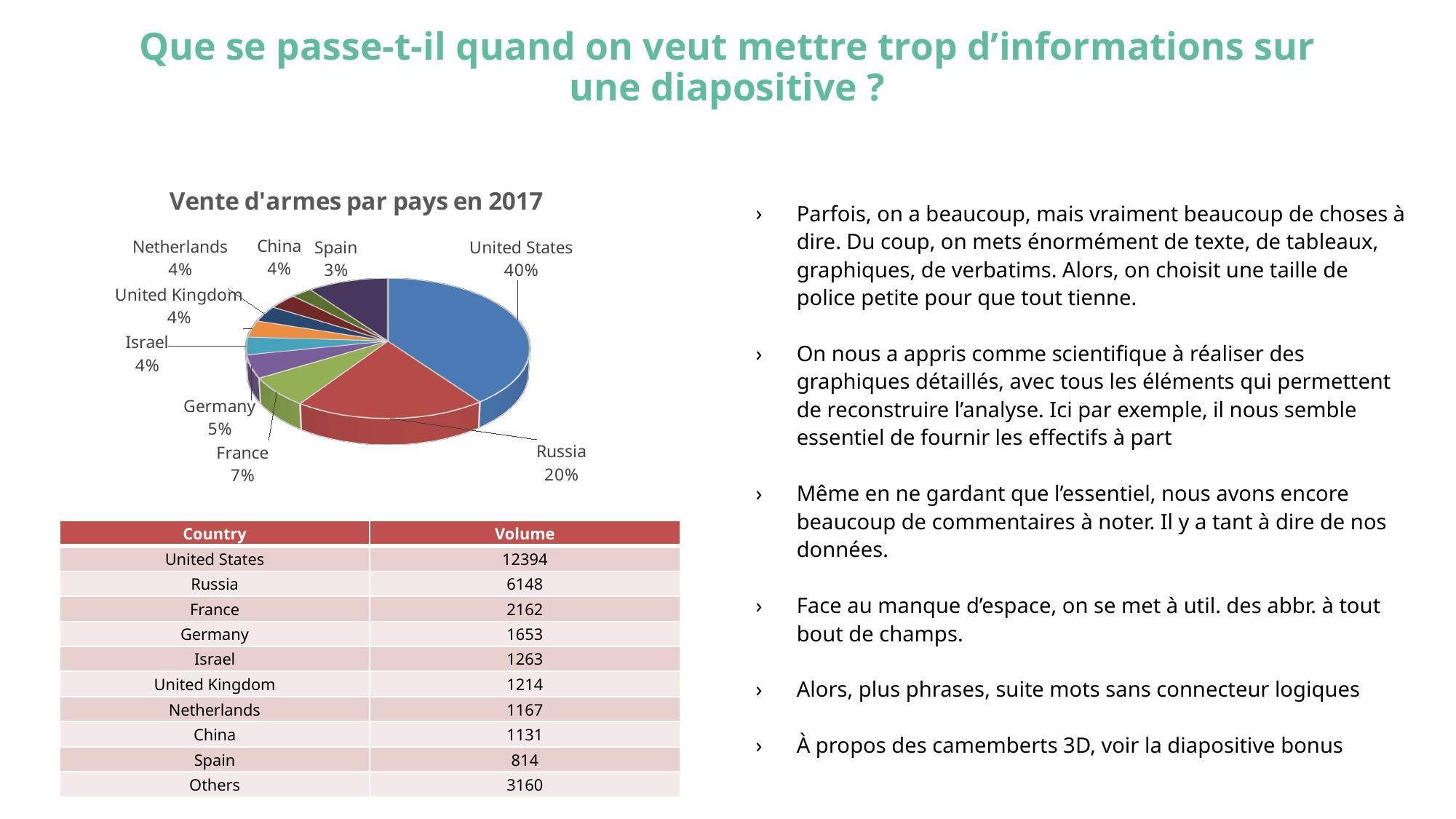
Which has a larger share, France or Germany? France Which country has the largest slice of the pie? United States How many percentage points larger is the United States share than the Russia share? 20 Which labelled country has the smallest slice of the pie? Spain What percentage is shown for Germany? 5% What is the title of the chart? Vente d'armes par pays en 2017 What share of the pie does Russia have? 20% What percentage is shown for France? 7% What type of chart is shown on the slide? Pie chart What percentage is shown for Spain? 3% What share of the pie does United States have? 40% What percentage is shown for Israel? 4%